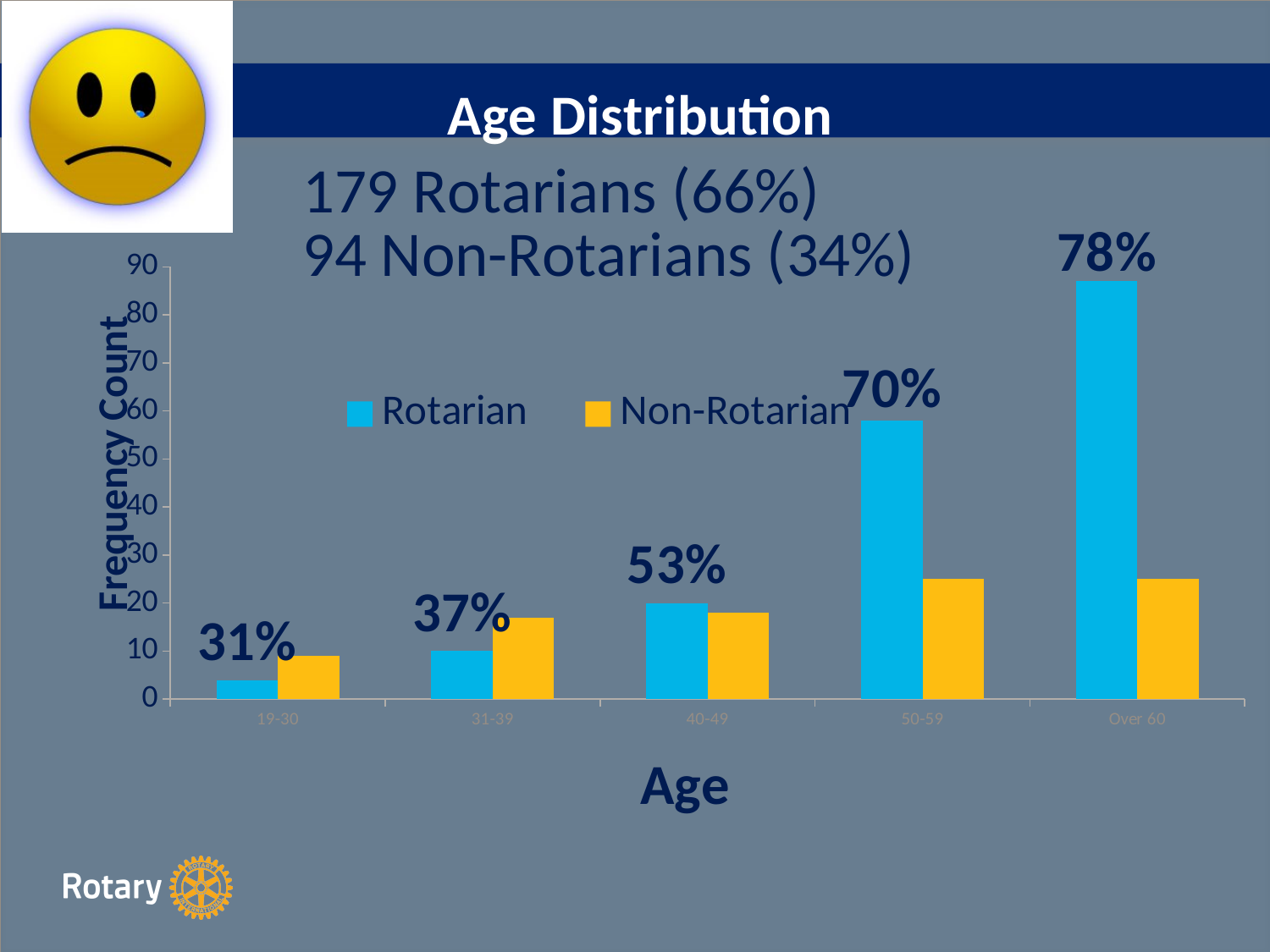
Do the Rotarian counts rise or fall as age increases along the x axis? rise Is the Rotarian value for Over 60 greater or less than 80? greater Which age group has the highest Rotarian frequency count? Over 60 Is the Rotarian value for 50-59 greater or less than 50? greater Which age group has the lowest Rotarian frequency count? 19-30 How many age categories are shown on the x axis? 5 In the Over 60 age group, which is larger, the Rotarian or the Non-Rotarian count? Rotarian What percentage label is printed above the Over 60 age group? 78% In the 19-30 age group, which is larger, the Rotarian or the Non-Rotarian count? Non-Rotarian How many series does the legend list? 2 What kind of chart is shown on the slide? bar chart